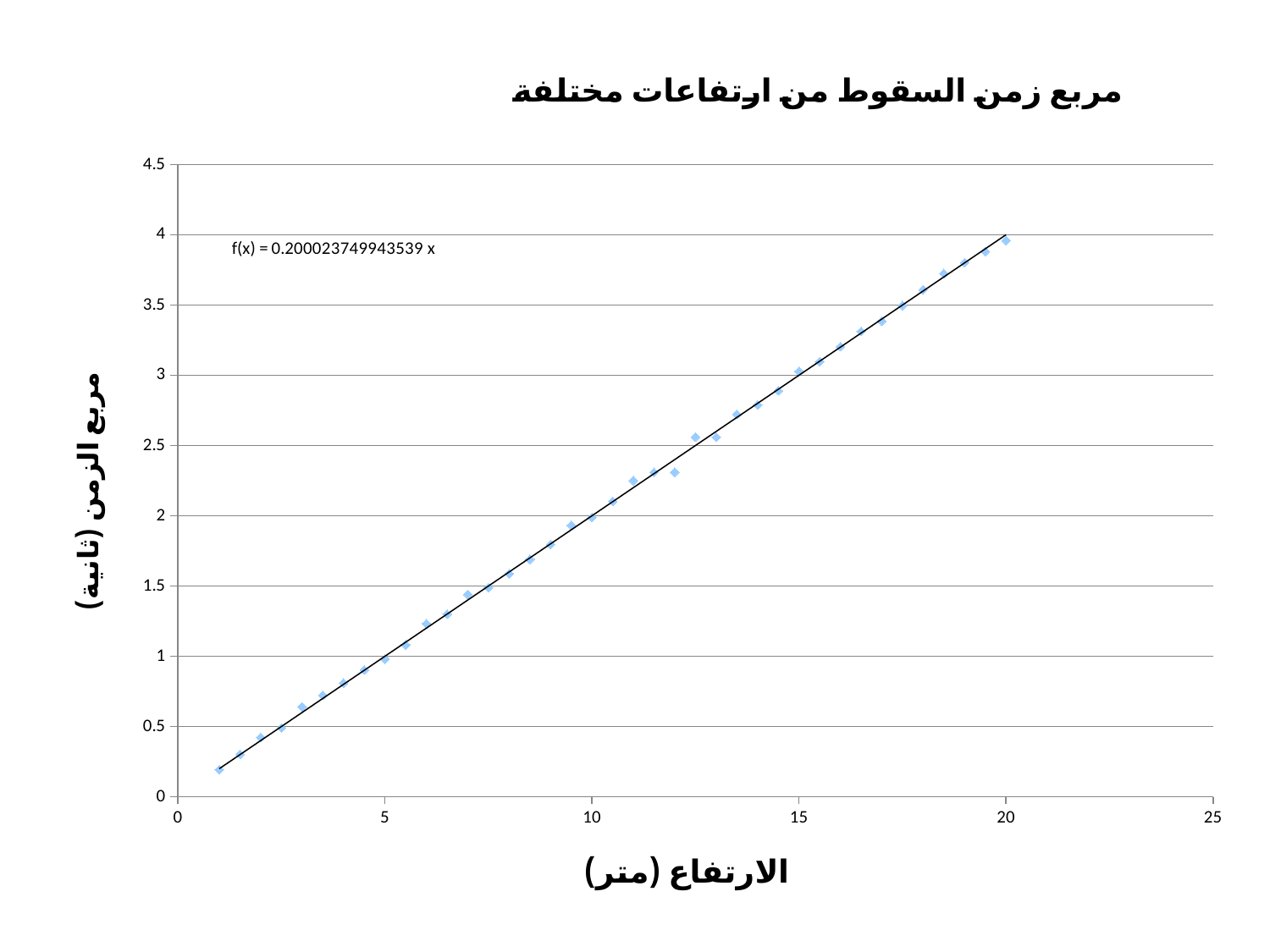
At which height is the plotted value lowest? 1 Which has the larger value: the point at height 10 or the point at height 15? Height 15 At which height is the plotted value highest? 20 Is the value for a height of 15 greater or less than 3.5? less Is the value for a height of 1 greater or less than 0.5? less Is the value for a height of 5 greater or less than 1.5? less Do the plotted values rise or fall as the height increases along the x axis? Rise What is the label of the x axis? الارتفاع (متر) What is the title of the chart? مربع زمن السقوط من ارتفاعات مختلفة What kind of chart is shown on the slide? Scatter chart